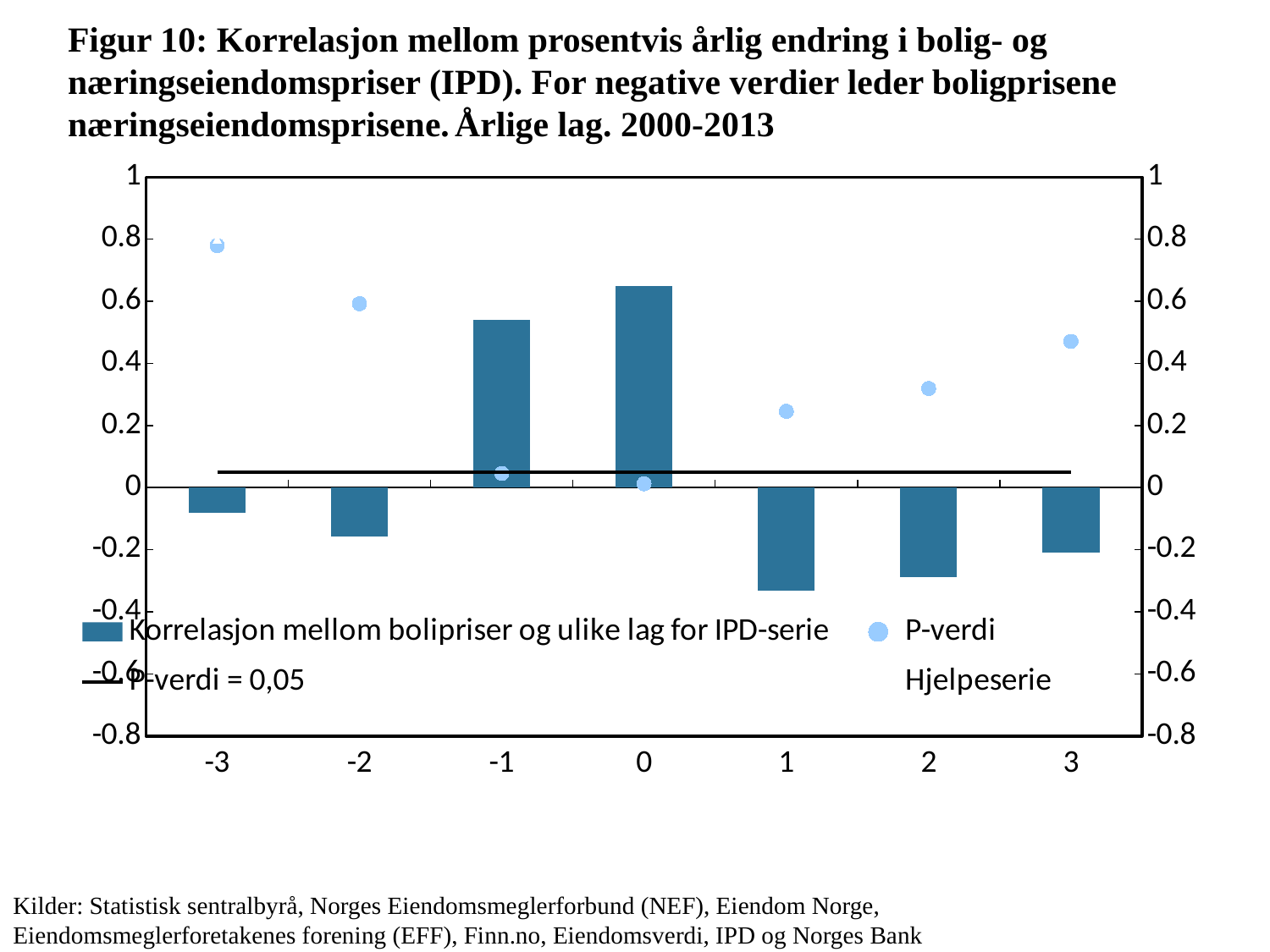
What kind of chart is shown on the slide? Bar chart with points (combination chart) At which lag is the correlation bar lowest? 1 Is the P-verdi point at lag 3 greater or less than 0.4? greater How many lag categories are shown on the x axis? 7 Which is larger, the P-verdi at lag -2 or the P-verdi at lag 2? lag -2 How many entries does the legend list? 4 Do the P-verdi points rise or fall from lag 0 to lag 3? rise Is the correlation bar at lag 1 greater or less than -0.2? less At which lag is the P-verdi point highest? -3 At which lag is the correlation bar highest? 0 Is the correlation bar at lag -1 greater or less than 0.6? less